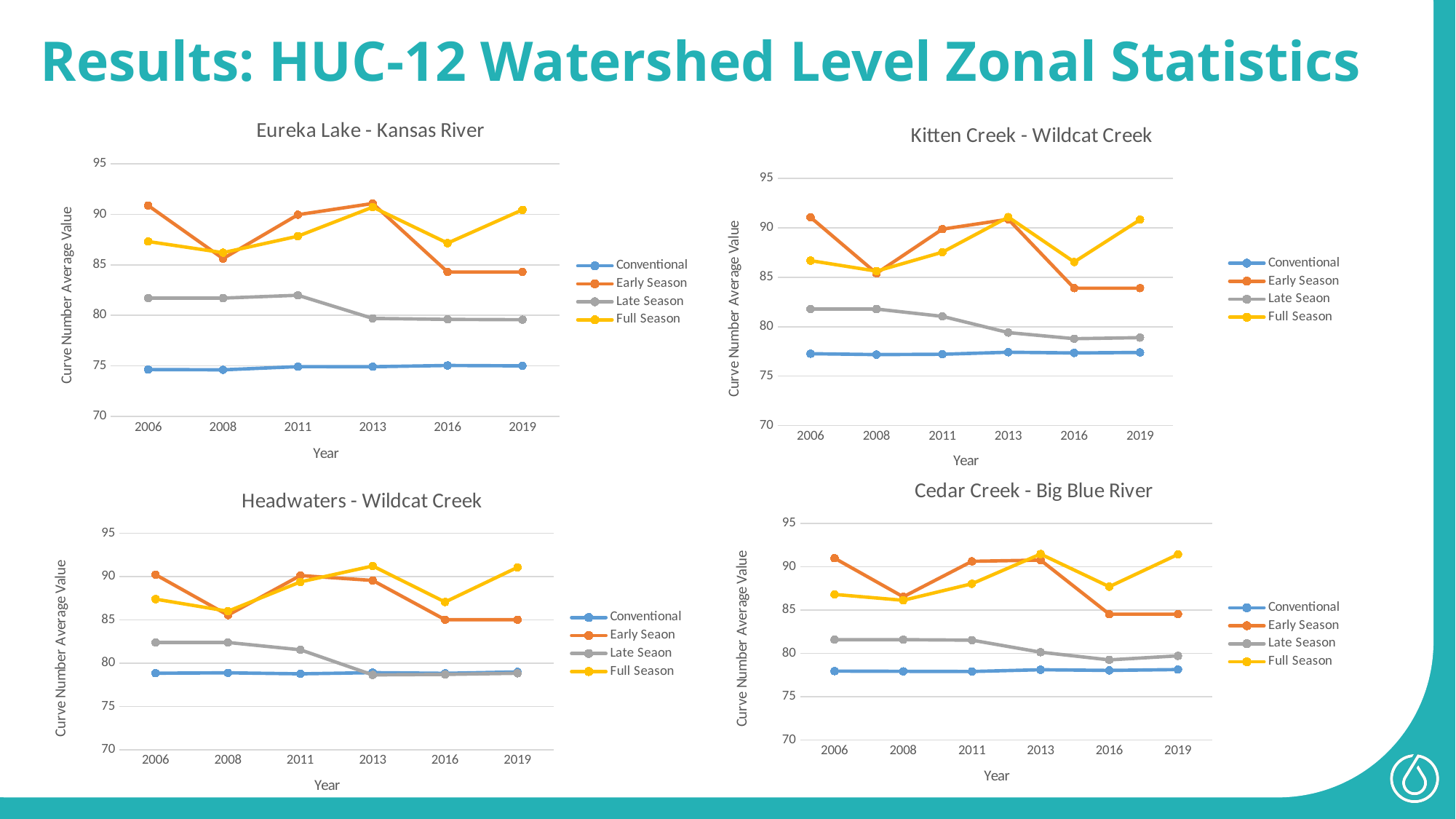
In the 'Headwaters - Wildcat Creek' chart, is the Full Season value for 2013 greater or less than 90? greater In the 'Kitten Creek - Wildcat Creek' chart, how many series does the legend list? 4 What is the y-axis label of the 'Cedar Creek - Big Blue River' chart? Curve Number Average Value What is the title of the chart in the bottom-right of the slide? Cedar Creek - Big Blue River In the 'Kitten Creek - Wildcat Creek' chart, does the Late Season series rise or fall from 2006 to 2019? fall In the 'Cedar Creek - Big Blue River' chart, which is higher in 2019: Full Season or Early Season? Full Season In the 'Eureka Lake - Kansas River' chart, which series has the highest value in 2006? Early Season In the 'Kitten Creek - Wildcat Creek' chart, is the Early Season value for 2016 greater or less than 85? less What kind of chart is 'Eureka Lake - Kansas River'? line chart In the 'Headwaters - Wildcat Creek' chart, which series has the lowest value in 2006? Conventional In the 'Eureka Lake - Kansas River' chart, is the Late Season value for 2006 greater or less than 80? greater In the 'Headwaters - Wildcat Creek' chart, how many years are shown on the x axis? 6